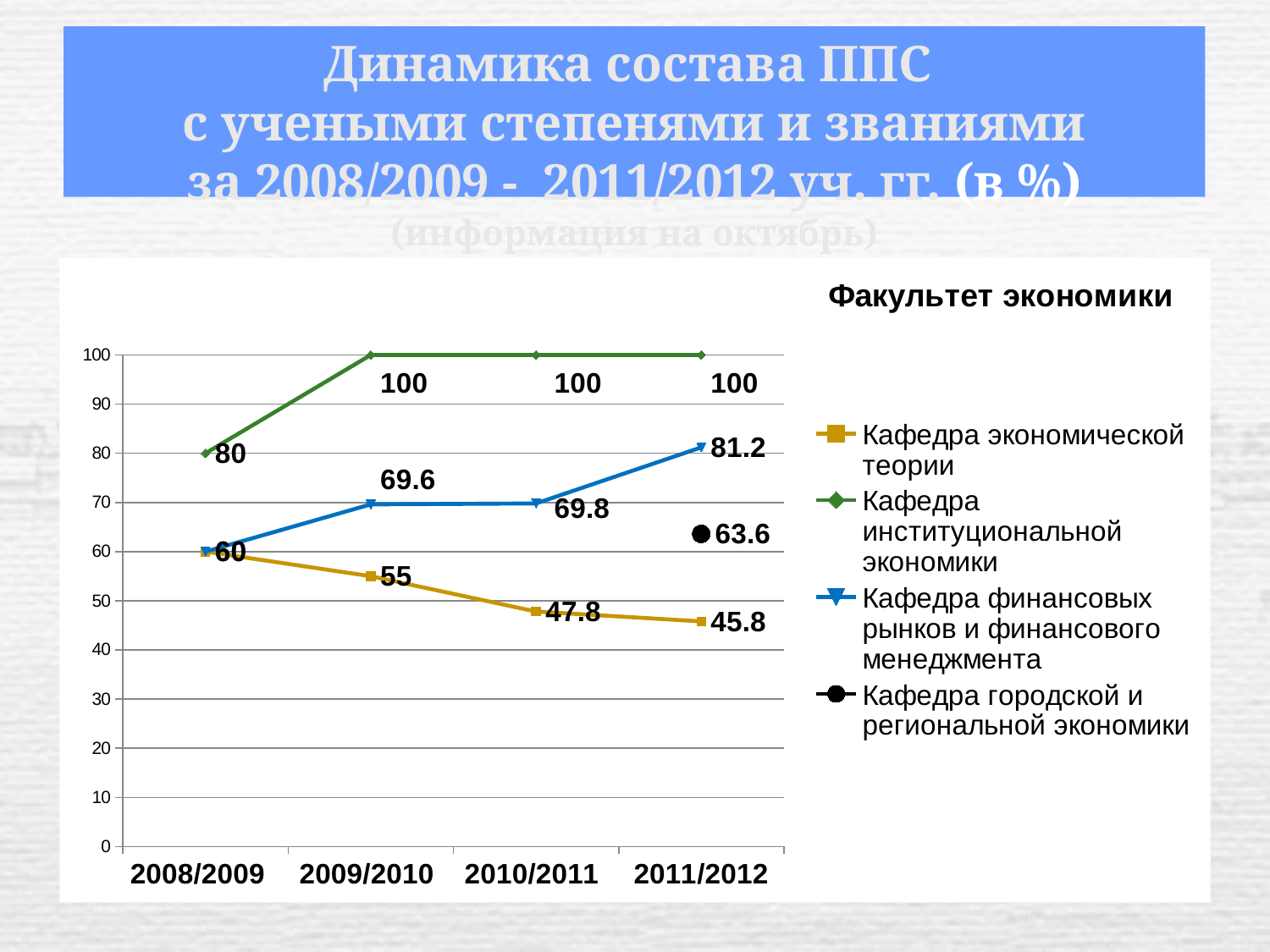
Which department has the highest value in 2011/2012? Кафедра институциональной экономики Do the values for Кафедра экономической теории rise or fall from 2008/2009 to 2011/2012? fall What is the value for Кафедра городской и региональной экономики in 2011/2012? 63.6 Which faculty is named above the legend of the chart? Факультет экономики By how much did the value for Кафедра финансовых рынков и финансового менеджмента increase from 2010/2011 to 2011/2012? 11.4 What is the value for Кафедра экономической теории in 2010/2011? 47.8 What kind of chart is shown on the slide? line chart In 2011/2012, which is larger: the value for Кафедра экономической теории or for Кафедра городской и региональной экономики? Кафедра городской и региональной экономики How many series does the legend list? 4 What is the value for Кафедра финансовых рынков и финансового менеджмента in 2011/2012? 81.2 How many academic years are shown on the x axis? 4 What is the value for Кафедра институциональной экономики in 2009/2010? 100